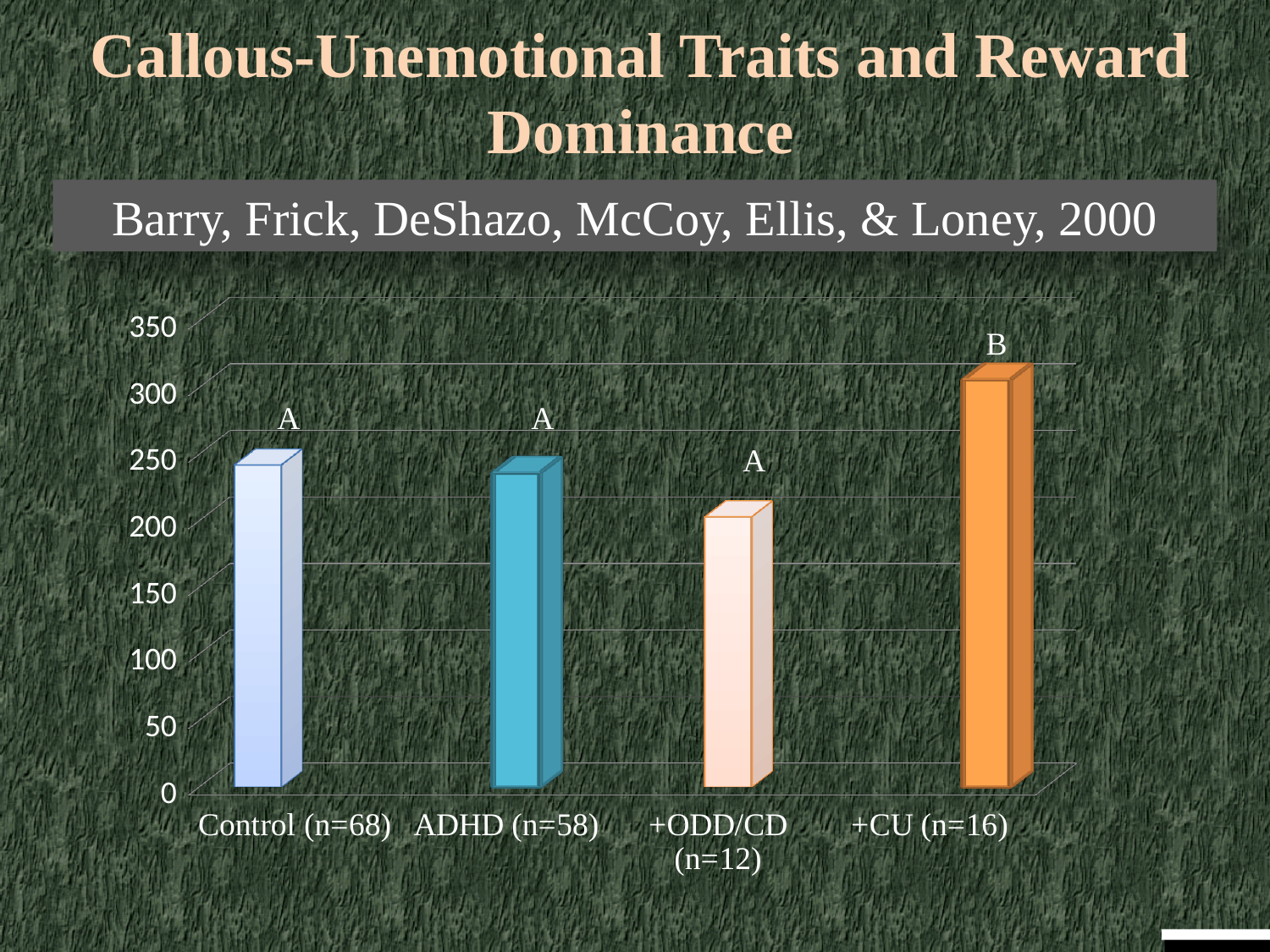
Is the value for ADHD (n=58) greater or less than 300? less Which bar is taller: Control (n=68) or +ODD/CD (n=12)? Control (n=68) What kind of chart is shown on the slide? bar chart What letter is printed above the +CU (n=16) bar? B What is the title of the slide containing the chart? Callous-Unemotional Traits and Reward Dominance Is the value for +ODD/CD (n=12) greater or less than 250? less Is the value for +CU (n=16) greater or less than 250? greater How many groups (bars) are plotted in the chart? 4 Which group has the lowest bar in the chart? +ODD/CD (n=12) Which bar is taller: +CU (n=16) or ADHD (n=58)? +CU (n=16) Which group has the highest bar in the chart? +CU (n=16)